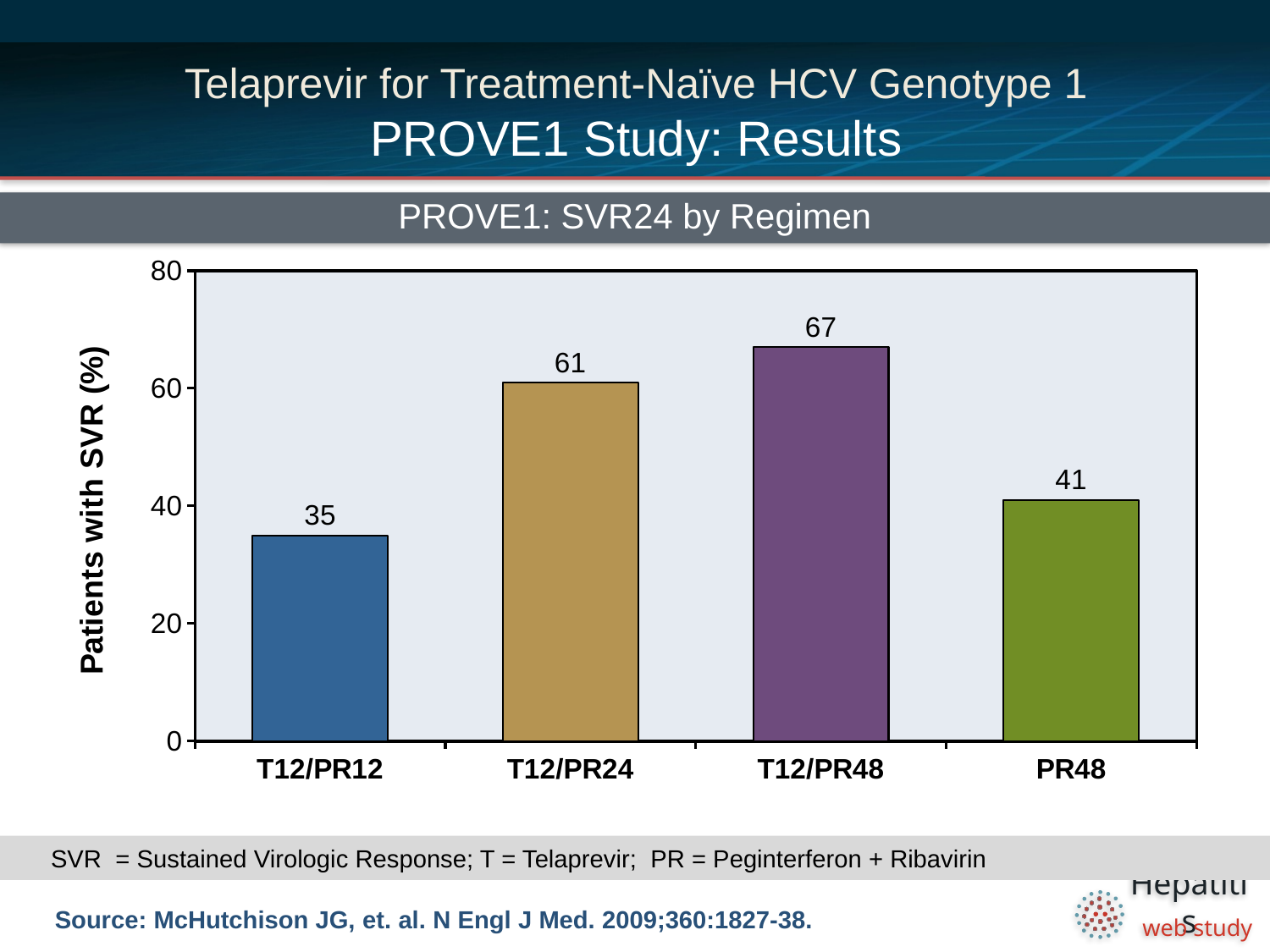
What kind of chart is shown on the slide? Bar chart Which regimen has the highest percentage of patients with SVR? T12/PR48 Which regimen has the lowest percentage of patients with SVR? T12/PR12 What is the value for T12/PR24? 61 What is the value for PR48? 41 What is the title of the chart? PROVE1: SVR24 by Regimen What is the value for T12/PR48? 67 What is the value for T12/PR12? 35 What is the difference between the values for T12/PR24 and T12/PR12? 26 What is the difference between the values for T12/PR48 and PR48? 26 How many regimens are shown on the chart? 4 Which is larger, the value for T12/PR24 or the value for PR48? T12/PR24